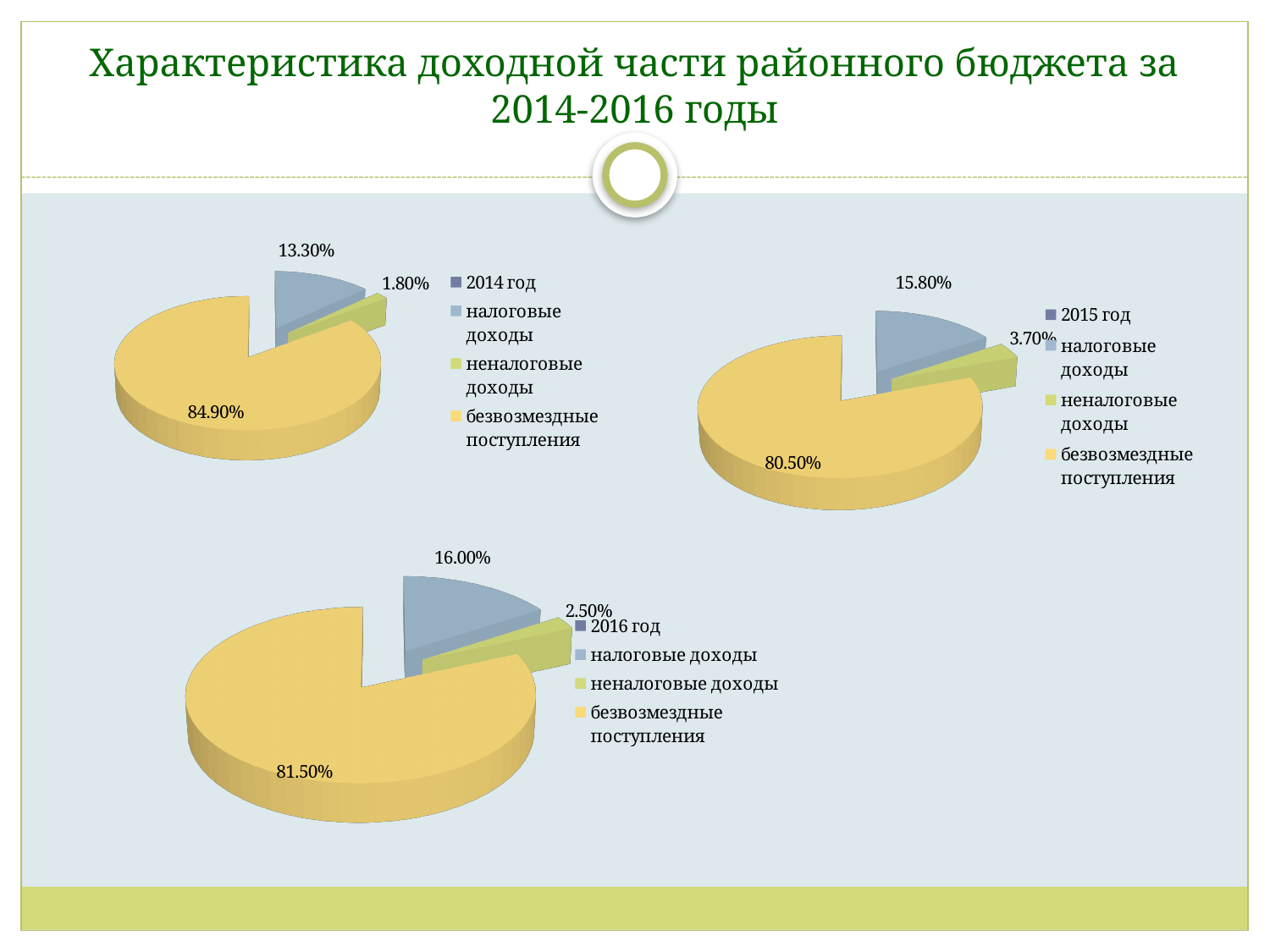
How many charts are shown on the slide? 3 In the 2016 pie chart, what share is shown for налоговые доходы? 16.00% In the 2014 pie chart, what share is shown for безвозмездные поступления? 84.90% In the 2014 pie chart, which category has the smallest slice? неналоговые доходы In the 2014 pie chart, what share is shown for налоговые доходы? 13.30% In the 2016 pie chart, what share is shown for безвозмездные поступления? 81.50% What type of chart is used for the 2014 data? Pie chart In the 2015 pie chart, what share is shown for неналоговые доходы? 3.70% In the 2015 pie chart, which category has the largest slice? безвозмездные поступления What is the difference between the безвозмездные поступления share in the 2014 pie chart and in the 2015 pie chart? 4.40% Which is larger: the неналоговые доходы share in the 2015 pie chart or in the 2016 pie chart? 2015 pie chart How many slices does the 2016 pie chart have? 3